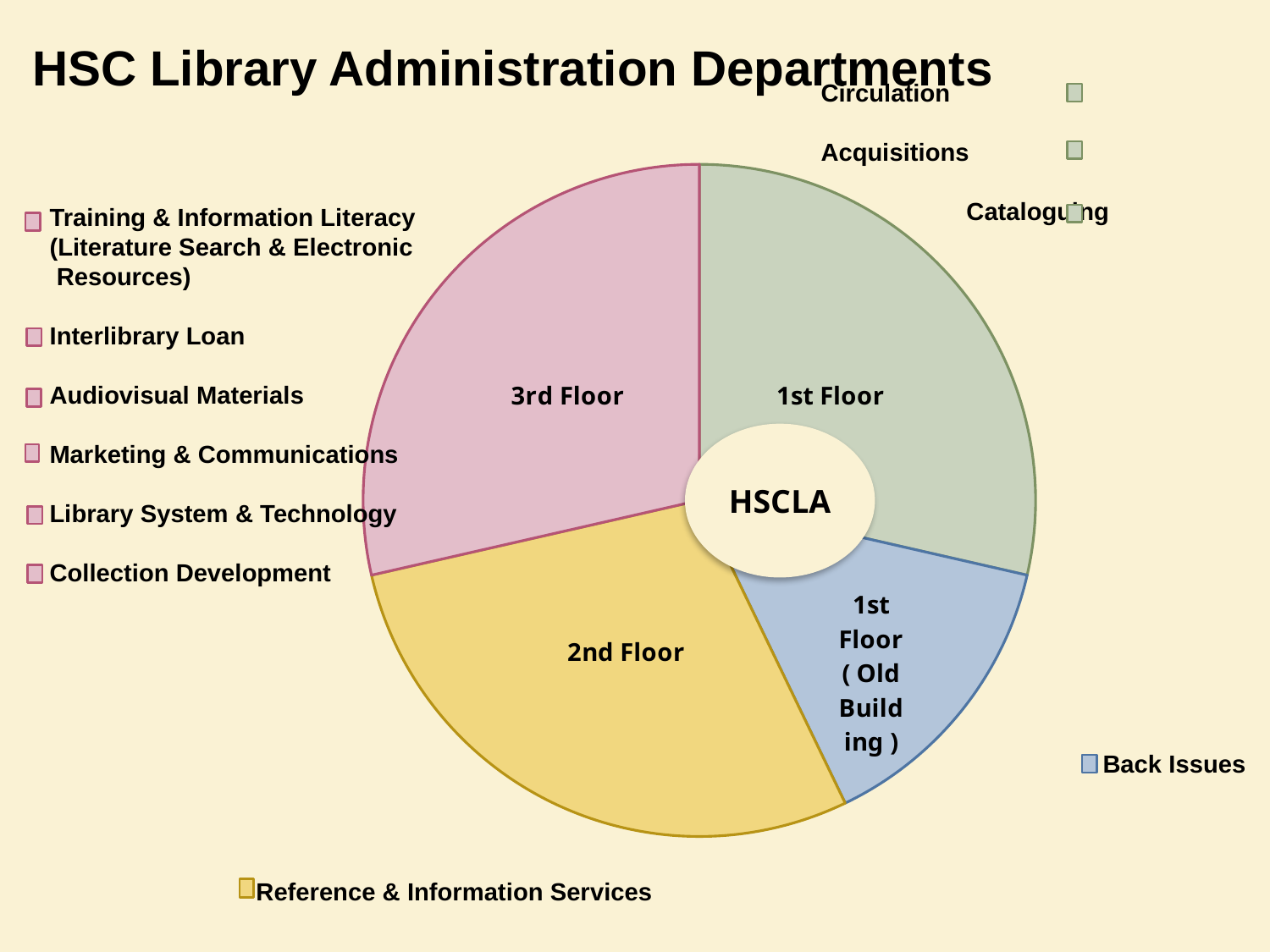
What kind of chart is shown on the slide? pie chart What label appears in the centre of the pie chart? HSCLA Which slice is larger, 2nd Floor or 1st Floor (Old Building)? 2nd Floor How many slices does the pie chart have? 4 What colour is the 2nd Floor slice of the pie chart? yellow Which slice is larger, 1st Floor or 1st Floor (Old Building)? 1st Floor Which slice of the pie chart is the smallest? 1st Floor (Old Building) Which slice is larger, 3rd Floor or 1st Floor (Old Building)? 3rd Floor